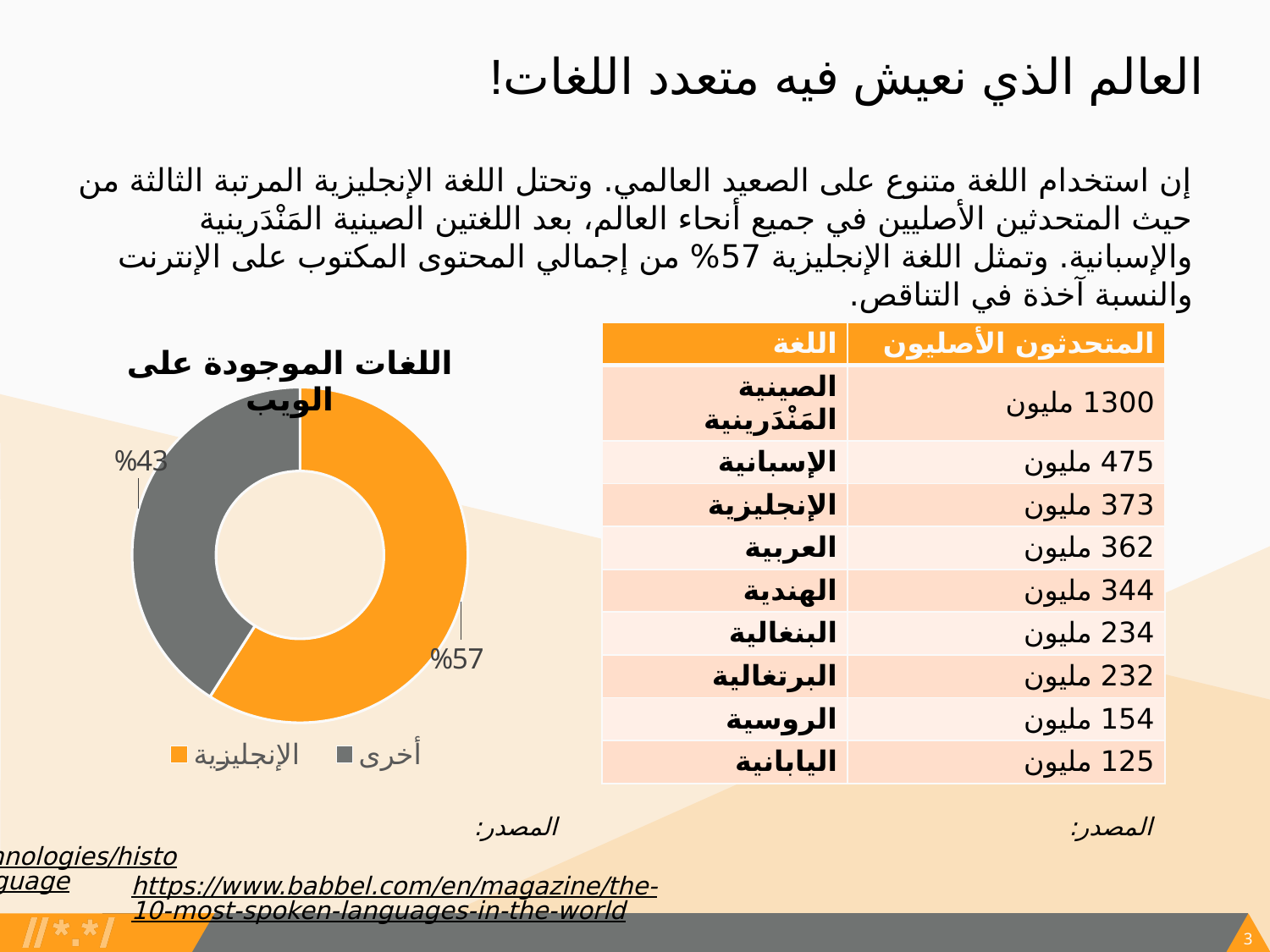
How many entries does the chart legend list? 2 What share of the chart does the أخرى slice represent? 43% What is the value shown for أخرى in the chart? 43% What is the value shown for الإنجليزية in the chart? 57% How many slices does the chart have? 2 Which is larger, the slice for الإنجليزية or the slice for أخرى? الإنجليزية What is the title of the chart? اللغات الموجودة على الويب Which category has the smallest slice in the chart? أخرى What kind of chart is shown on the slide? Pie (doughnut) chart Which category has the largest slice in the chart? الإنجليزية What colour is the slice for الإنجليزية in the chart? Orange What is the difference between the values for الإنجليزية and أخرى? 14%